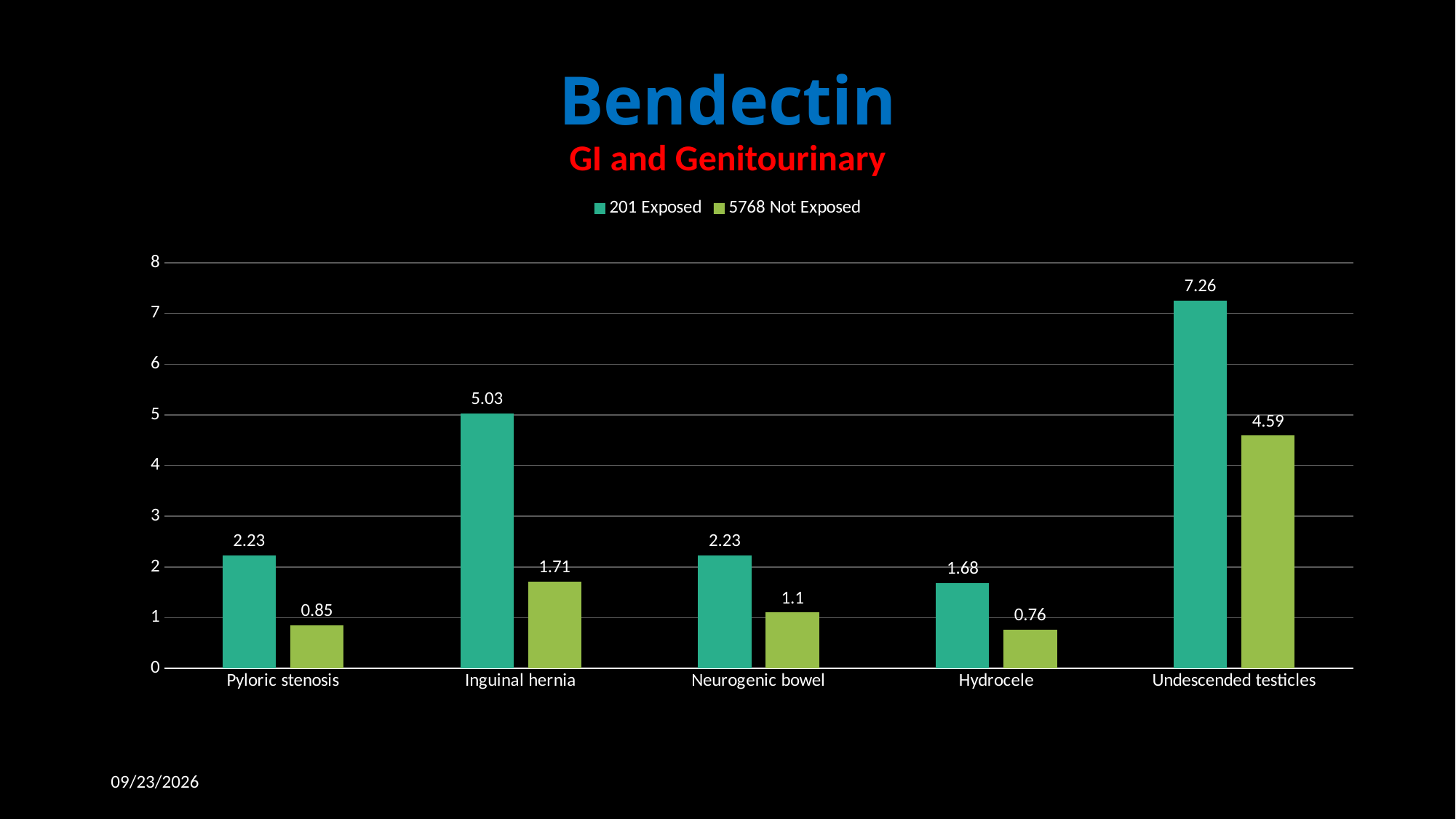
What kind of chart is shown on the slide? Bar chart Which category has the highest value for 201 Exposed? Undescended testicles What is the difference between the 201 Exposed and 5768 Not Exposed values for Pyloric stenosis? 1.38 What is the value for 201 Exposed for Inguinal hernia? 5.03 What is the value for 5768 Not Exposed for Neurogenic bowel? 1.1 What is the subtitle shown in red below the chart title? GI and Genitourinary How many series does the legend list? 2 How many categories are shown on the x axis? 5 What is the value for 5768 Not Exposed for Hydrocele? 0.76 Which is larger: the 201 Exposed value for Hydrocele or the 5768 Not Exposed value for Inguinal hernia? 5768 Not Exposed value for Inguinal hernia What is the difference between the 201 Exposed and 5768 Not Exposed values for Undescended testicles? 2.67 Which category has the lowest value for 5768 Not Exposed? Hydrocele